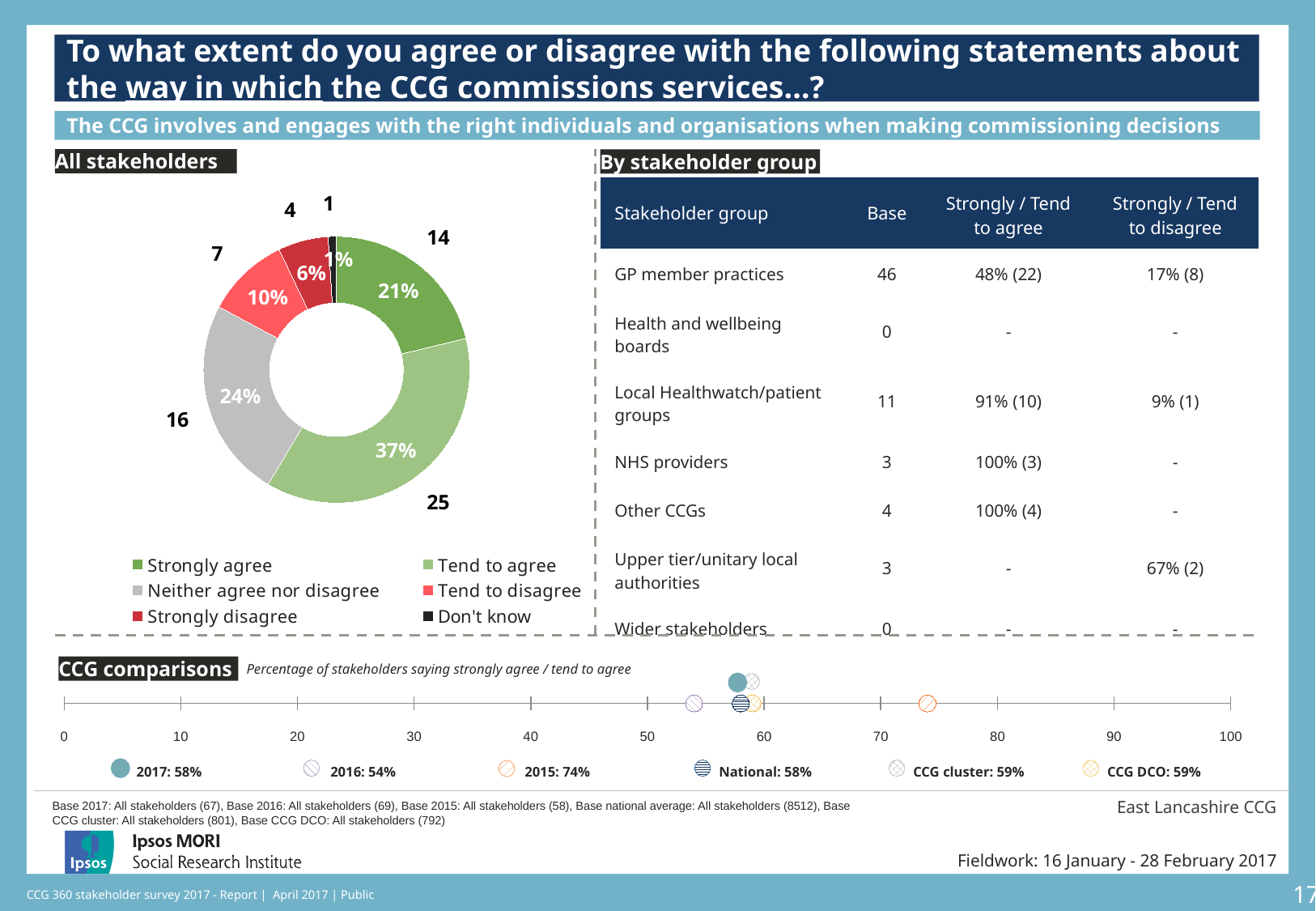
In the 'CCG comparisons' chart, which year has the highest percentage of stakeholders saying strongly agree / tend to agree? 2015 What type of chart is used in the 'All stakeholders' section? Donut (pie) chart How many response categories does the legend of the 'All stakeholders' donut chart list? 6 In the 'All stakeholders' donut chart, which response category has the smallest share? Don't know In the 'All stakeholders' donut chart, which is larger: the share for 'Tend to disagree' or the share for 'Strongly disagree'? Tend to disagree In the 'CCG comparisons' chart, what percentage is shown for 2017? 58% In the 'All stakeholders' donut chart, what percentage of stakeholders said 'Tend to agree'? 37% In the 'All stakeholders' donut chart, what is the difference in percentage points between 'Tend to agree' and 'Strongly agree'? 16 In the 'All stakeholders' donut chart, which response category has the largest share? Tend to agree In the 'All stakeholders' donut chart, how many stakeholders said 'Strongly agree'? 14 In the 'CCG comparisons' chart, what is the difference in percentage points between 2015 and 2016? 20 In the 'All stakeholders' donut chart, what percentage of stakeholders said 'Neither agree nor disagree'? 24%